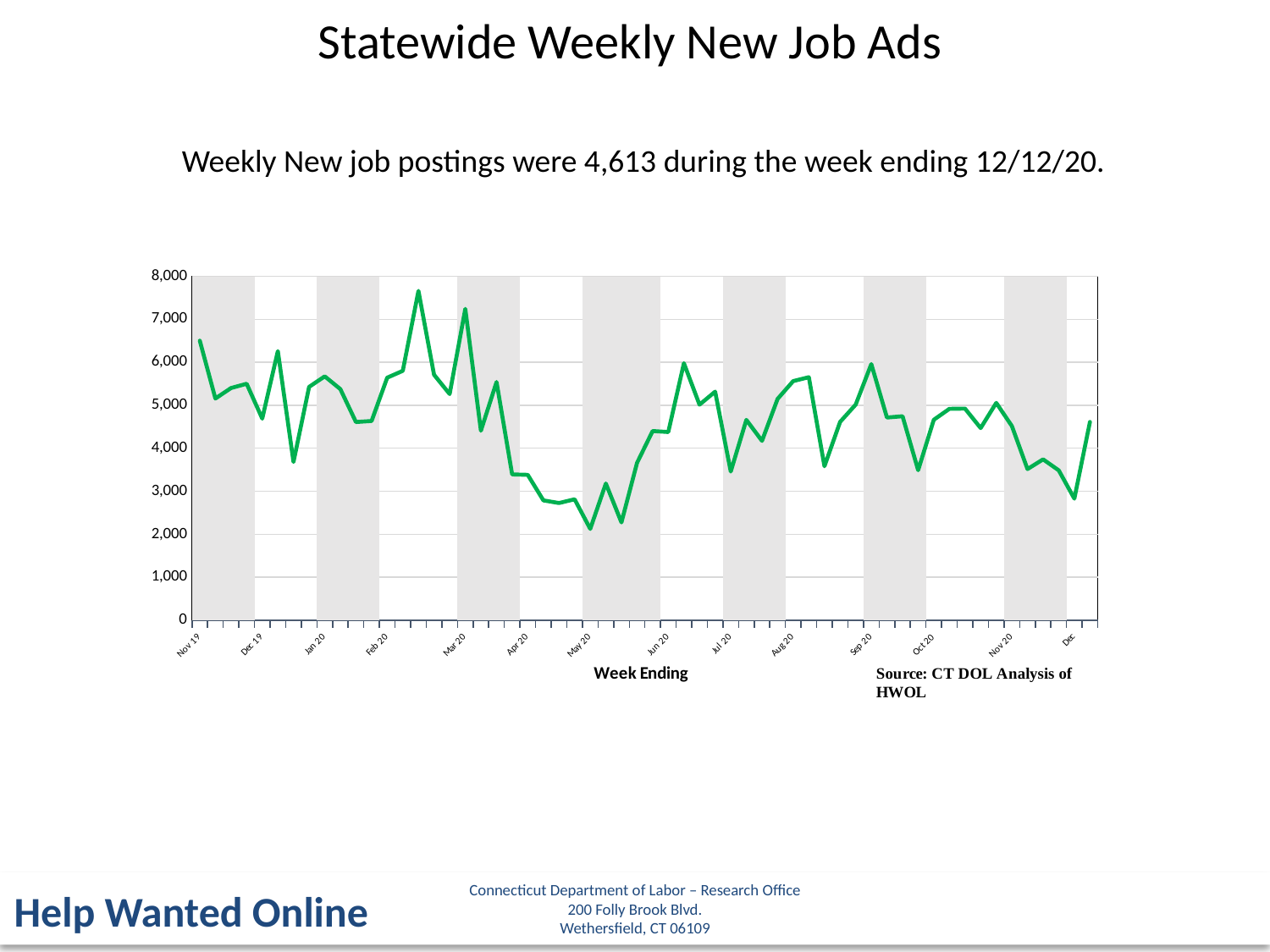
Is the value at the first point (Nov 19) greater or less than 6,000? greater According to the slide, how many weekly new job postings were there during the week ending 12/12/20? 4,613 How many data series are plotted on the chart? 1 Is the value at Sep 20 greater or less than 5,000? greater Is the highest point on the line greater or less than 7,000? greater What kind of chart is shown on the slide? line chart Do the values generally rise or fall between May 20 and Jun 20? rise What is the title of the chart on the slide? Statewide Weekly New Job Ads Do the values generally rise or fall between Feb 20 and May 20? fall What is the label on the x axis of the chart? Week Ending